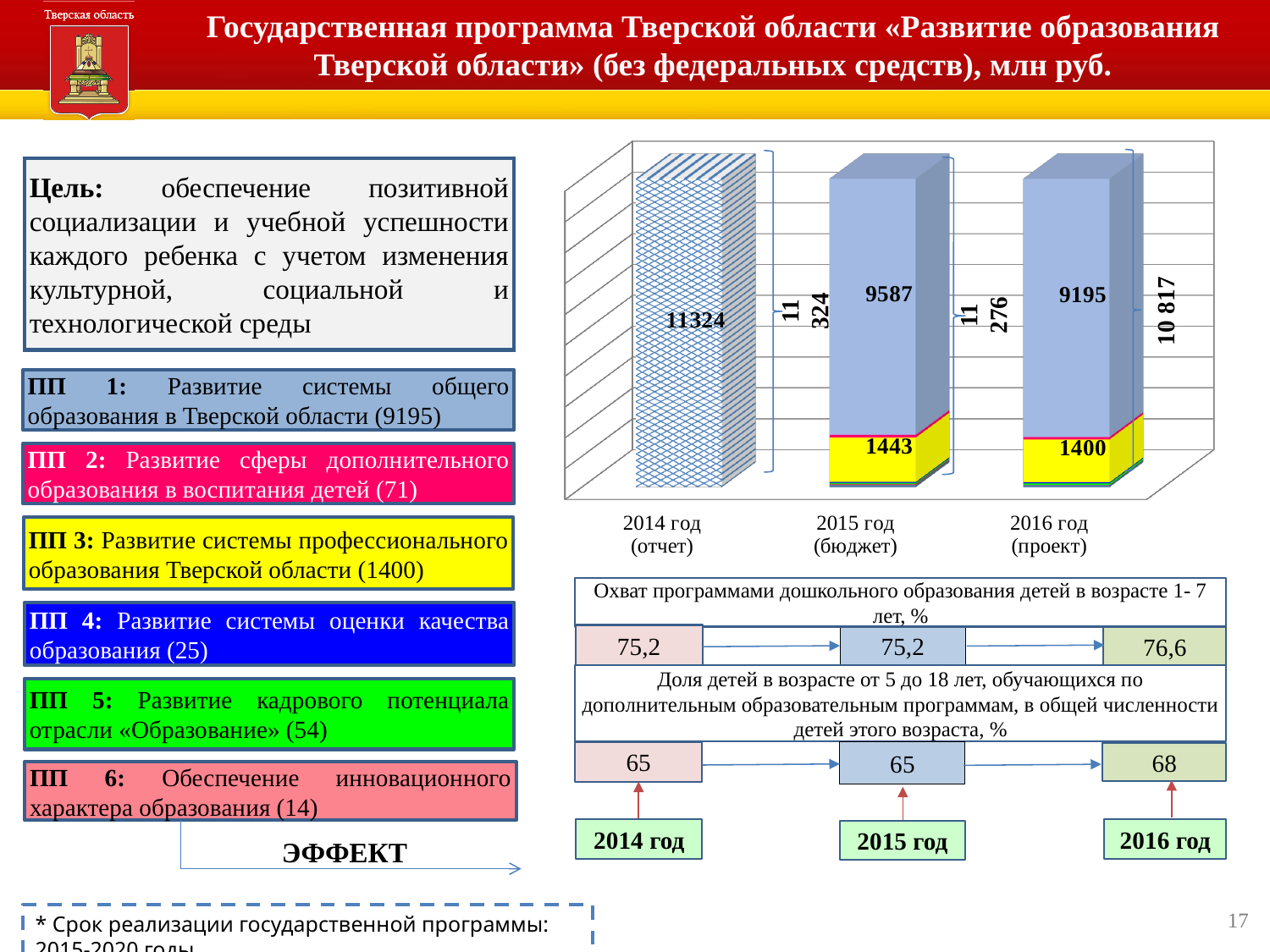
What is the value of the yellow segment for 2015 год (бюджет)? 1443 How many years (bars) are shown in the chart? 3 What value is printed on the bar for 2014 год (отчет)? 11324 What is the value of the large blue segment for 2015 год (бюджет)? 9587 Which is larger, the yellow segment for 2015 год or for 2016 год? 2015 год Do the bar totals rise or fall from 2014 to 2016? fall Which year has the lowest total? 2016 год (проект) What is the total printed beside the bar for 2016 год (проект)? 10 817 What is the value of the large blue segment for 2016 год (проект)? 9195 What is the value of the yellow segment for 2016 год (проект)? 1400 What is the total printed beside the bar for 2015 год (бюджет)? 11 276 What is the difference between the blue segment values for 2015 год and 2016 год? 392